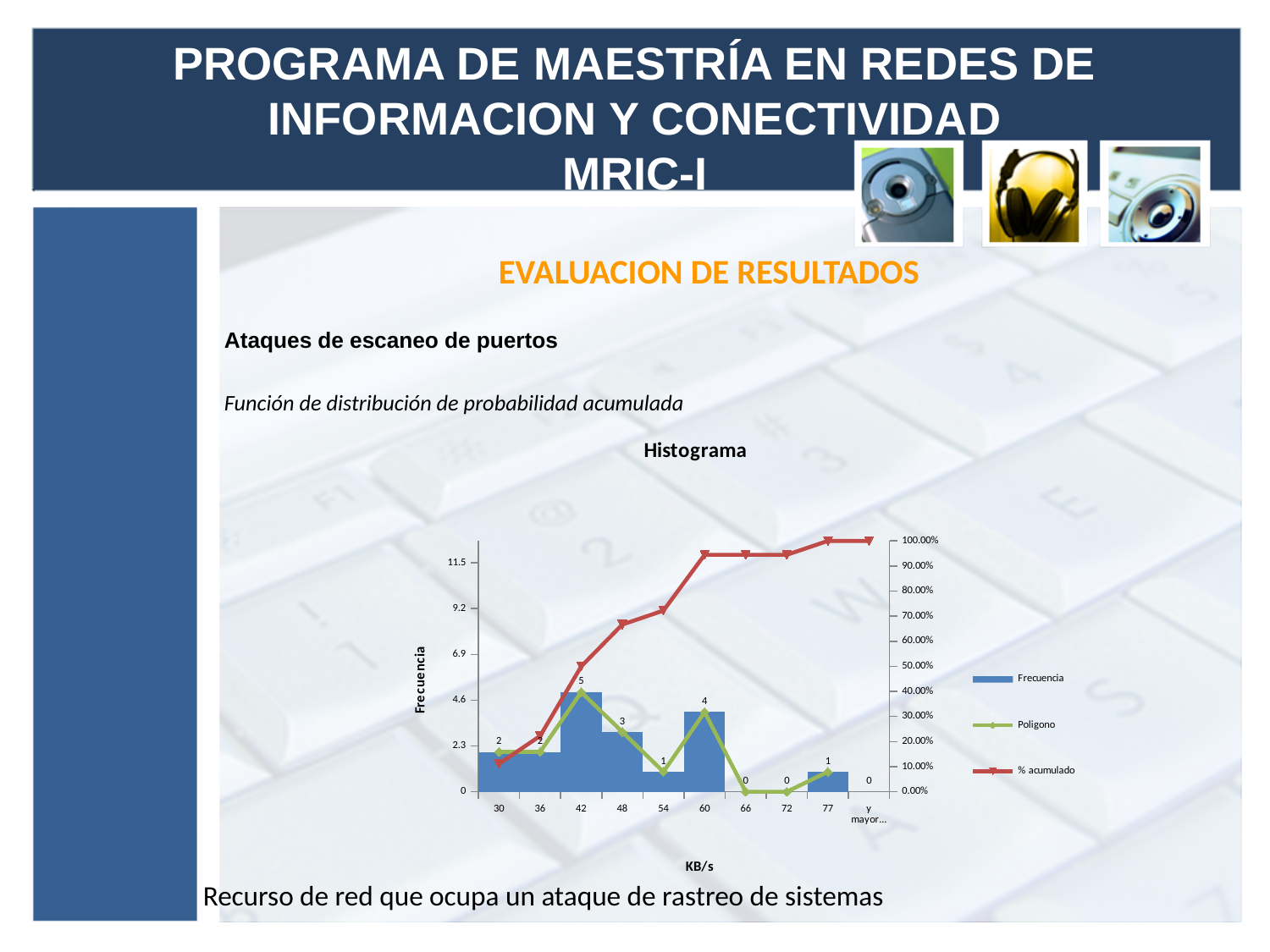
How many categories are shown on the x axis of the chart? 10 Which has a larger Frecuencia value, 48 or 54 KB/s? 48 What kind of chart is used to plot the Frecuencia series? bar chart Is the % acumulado value for 30 KB/s greater or less than 20.00%? less Which category has the highest Frecuencia value? 42 Is the % acumulado value for 60 KB/s greater or less than 90.00%? greater What is the Frecuencia value for the 60 KB/s category? 4 How many series does the chart legend list? 3 What is the Frecuencia value for the 77 KB/s category? 1 What is the title of the chart on the slide? Histograma What is the difference between the Frecuencia values for 42 and 48 KB/s? 2 What is the Frecuencia value for the 42 KB/s category? 5